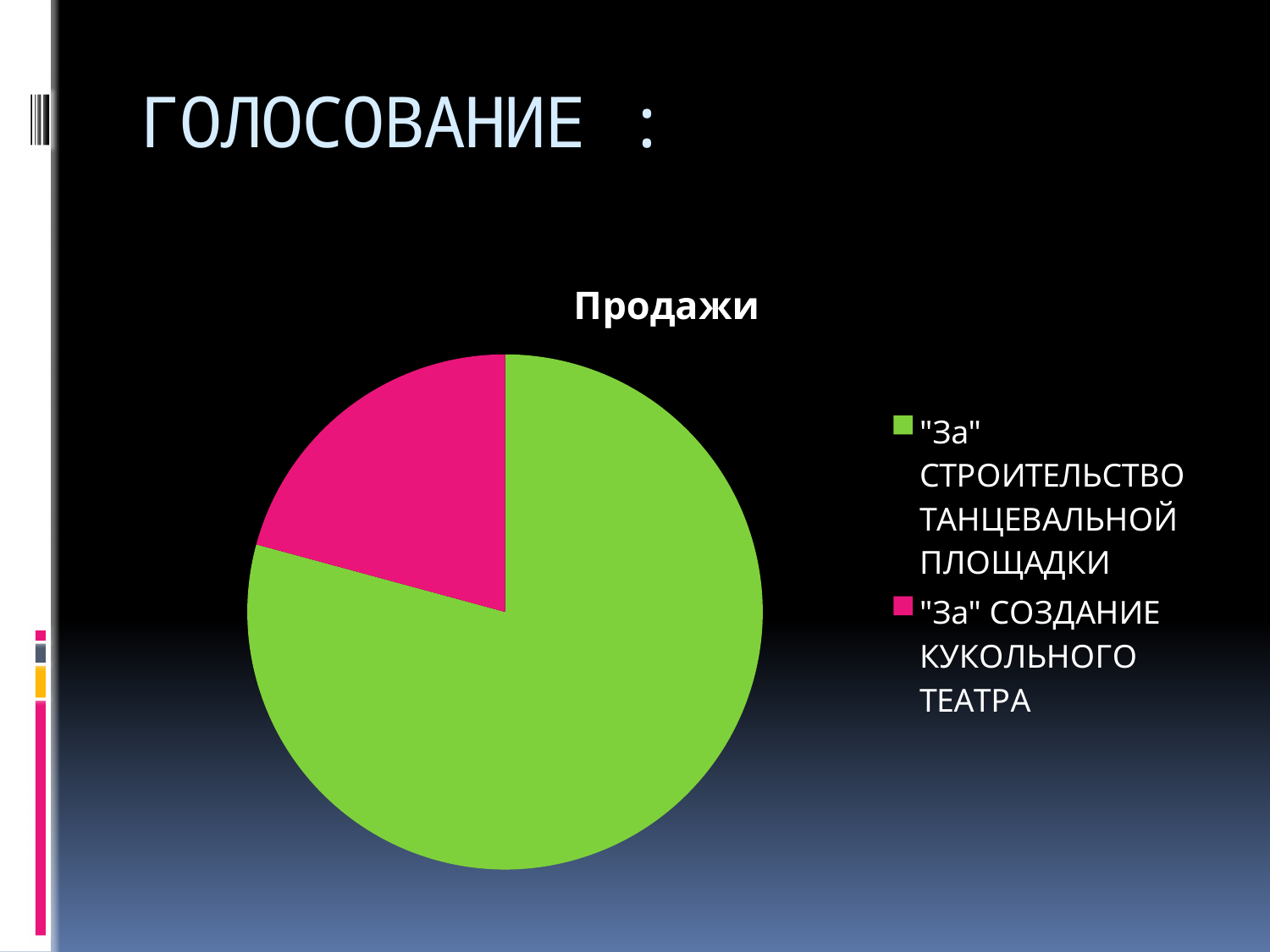
What kind of chart is shown on the slide? pie chart Which is larger: the slice for "За" СТРОИТЕЛЬСТВО ТАНЦЕВАЛЬНОЙ ПЛОЩАДКИ or the slice for "За" СОЗДАНИЕ КУКОЛЬНОГО ТЕАТРА? "За" СТРОИТЕЛЬСТВО ТАНЦЕВАЛЬНОЙ ПЛОЩАДКИ What colour is the slice for "За" СОЗДАНИЕ КУКОЛЬНОГО ТЕАТРА? pink Which category has the smallest slice of the pie? "За" СОЗДАНИЕ КУКОЛЬНОГО ТЕАТРА What is the title of the chart? Продажи Which category has the largest slice of the pie? "За" СТРОИТЕЛЬСТВО ТАНЦЕВАЛЬНОЙ ПЛОЩАДКИ How many entries does the legend list? 2 How many slices does the pie chart have? 2